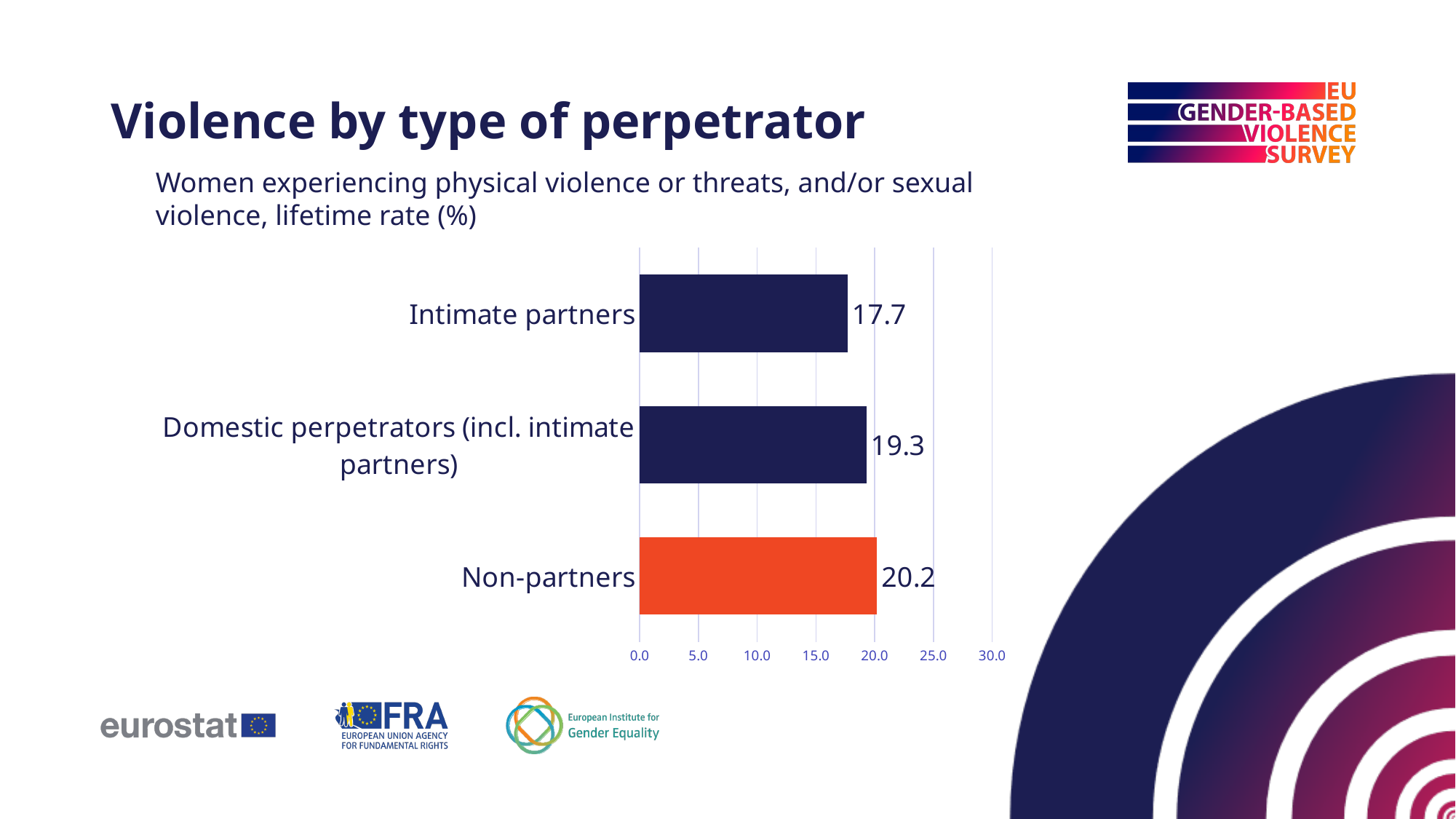
What is the difference between the values for Domestic perpetrators (incl. intimate partners) and Intimate partners? 1.6 Which category's bar is coloured orange? Non-partners What is the value for Intimate partners? 17.7 What is the value for Non-partners? 20.2 What is the difference between the values for Non-partners and Intimate partners? 2.5 Which is larger, the value for Non-partners or the value for Domestic perpetrators (incl. intimate partners)? Non-partners What kind of chart is shown on the slide? bar chart What is the value for Domestic perpetrators (incl. intimate partners)? 19.3 How many categories are shown in the chart? 3 Which category has the highest value? Non-partners Is the value for Intimate partners greater or less than 20.0? less Which category has the lowest value? Intimate partners